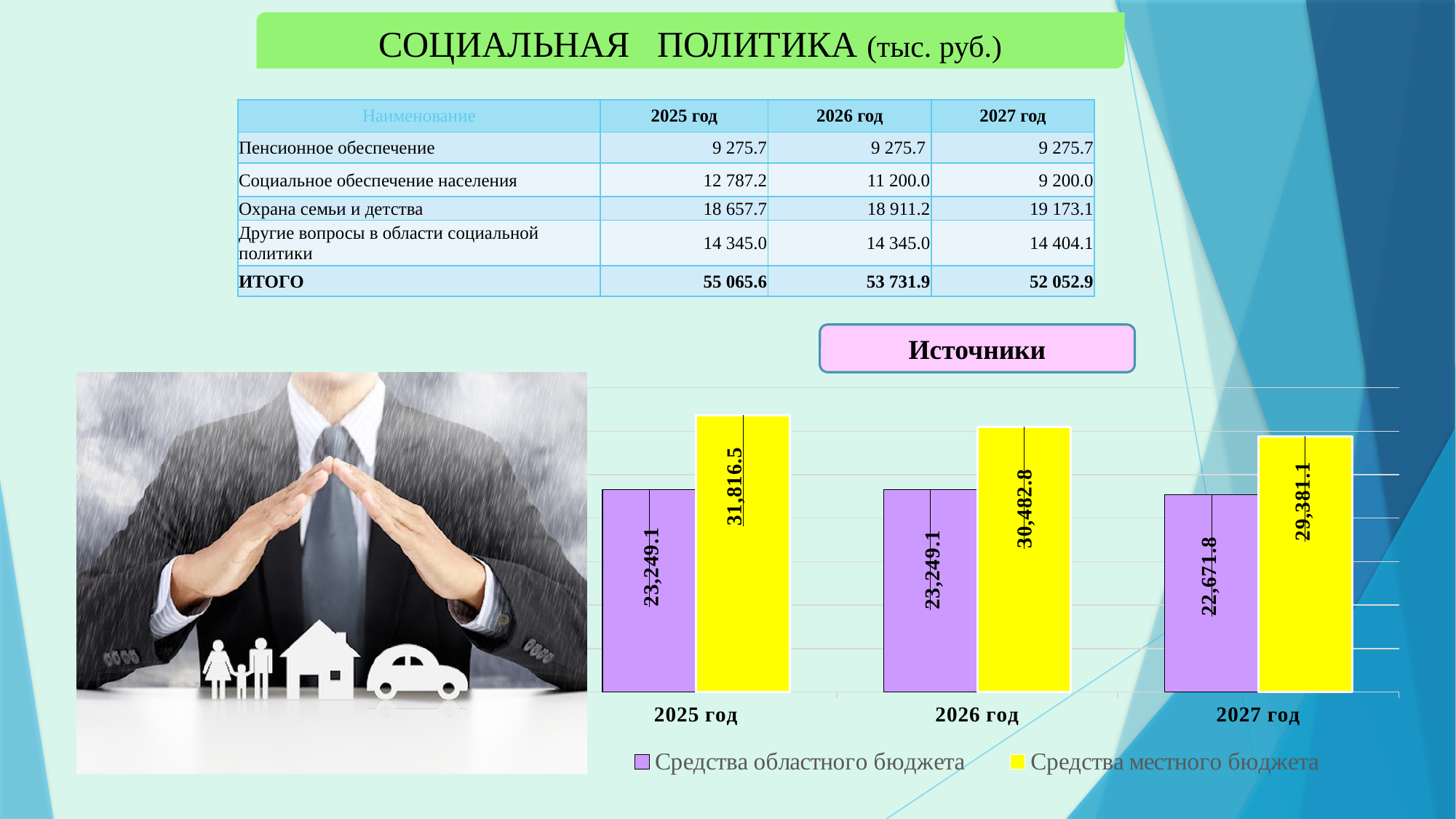
In which year is the value for Средства местного бюджета the highest? 2025 год How many series does the chart legend list? 2 Which is larger in 2027 год: Средства областного бюджета or Средства местного бюджета? Средства местного бюджета What is the value for Средства местного бюджета in 2025 год? 31,816.5 Do the values for Средства местного бюджета rise or fall from 2025 год to 2027 год? Fall What is the value for Средства местного бюджета in 2026 год? 30,482.8 What kind of chart is shown under the heading Источники? Bar chart What is the difference between Средства местного бюджета and Средства областного бюджета in 2025 год? 8,567.4 What is the difference between Средства местного бюджета in 2025 год and in 2027 год? 2,435.4 How many years (categories) are shown on the x axis of the chart? 3 In which year is the value for Средства областного бюджета the lowest? 2027 год What is the value for Средства областного бюджета in 2027 год? 22,671.8